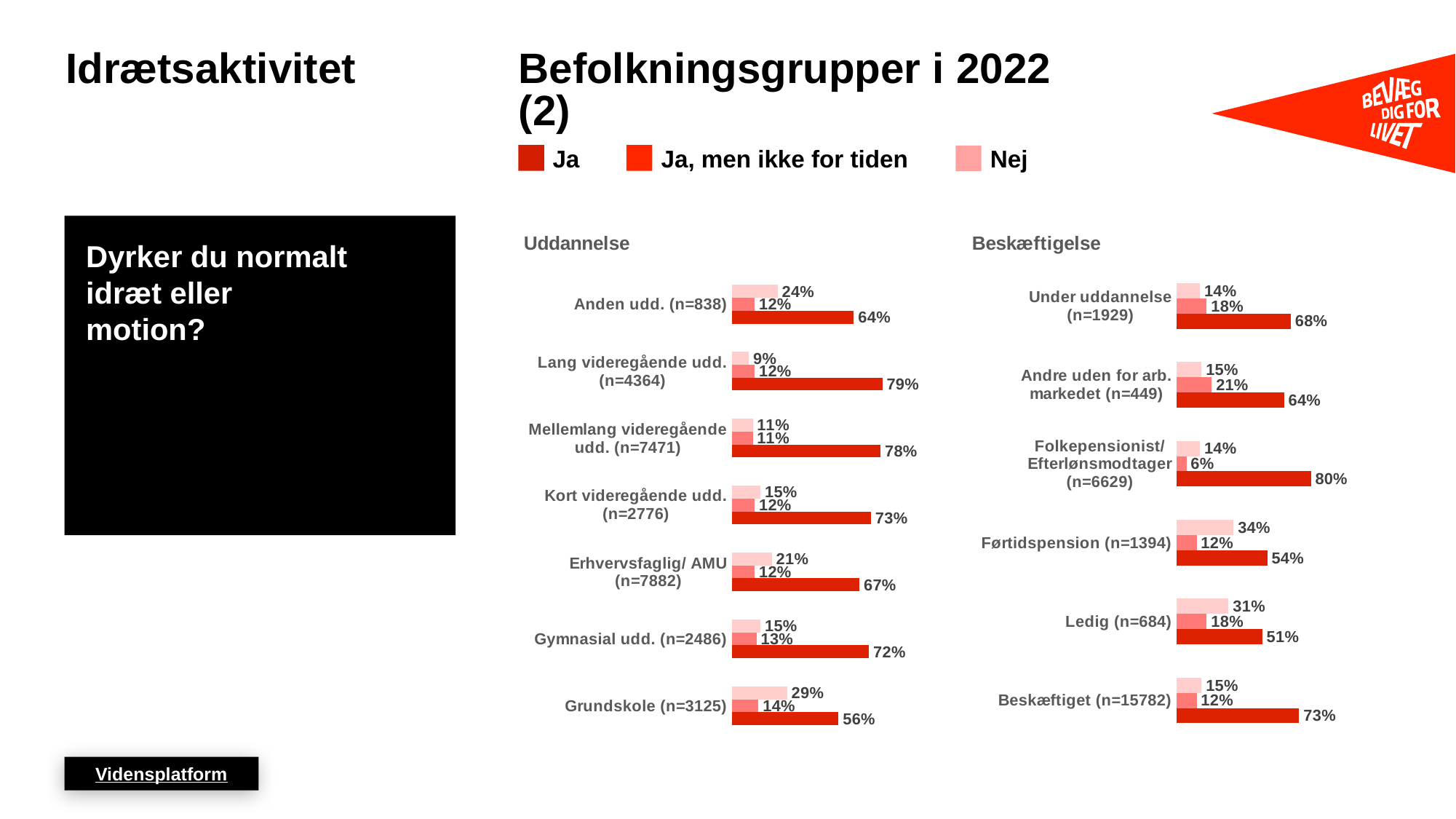
In the Uddannelse chart, what is the difference between the 'Ja' values for Lang videregående udd. and Grundskole? 23% How many series does the legend list? 3 How many categories are shown in the Uddannelse chart? 7 What kind of chart is the Beskæftigelse chart? Bar chart In the Uddannelse chart, which category has the highest 'Ja' value? Lang videregående udd. (n=4364) In the Beskæftigelse chart, which is larger: the 'Ja' value for Under uddannelse or for Beskæftiget? Beskæftiget How many categories are shown in the Beskæftigelse chart? 6 In the Uddannelse chart, what is the 'Nej' value for Grundskole (n=3125)? 29% In the Uddannelse chart, what is the 'Ja' value for Lang videregående udd. (n=4364)? 79% In the Beskæftigelse chart, what is the 'Nej' value for Førtidspension (n=1394)? 34% In the Beskæftigelse chart, what is the 'Ja, men ikke for tiden' value for Folkepensionist/Efterlønsmodtager (n=6629)? 6% In the Beskæftigelse chart, which category has the lowest 'Ja' value? Ledig (n=684)